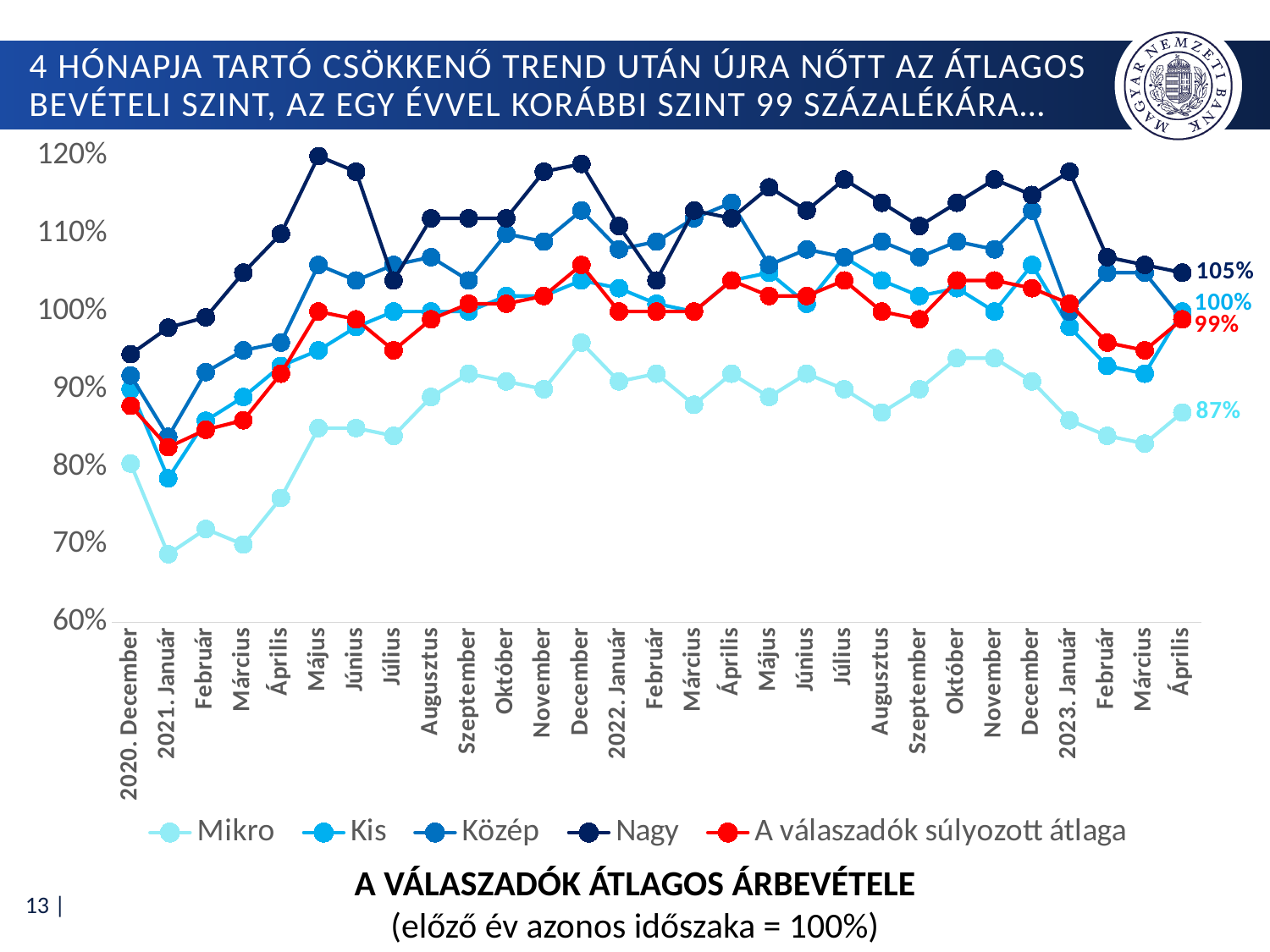
Is the value for Nagy in 2021 December greater or less than 110%? greater Which series has the lowest value in 2023 Április? Mikro Which series has the highest value in 2023 Április? Nagy What kind of chart is shown on the slide? Line chart What is the title of the chart? A VÁLASZADÓK ÁTLAGOS ÁRBEVÉTELE (előző év azonos időszaka = 100%) Is the value for Mikro in 2021 Január greater or less than 70%? less How many series does the legend list? 5 What value is labelled at the end of the Mikro line (2023 Április)? 87% What is the difference between the labelled Nagy value (105%) and the labelled Mikro value (87%) in 2023 Április? 18 percentage points What value is labelled at the end of the Nagy line (2023 Április)? 105% How many months (points) are shown along the x axis? 29 What value is labelled at the end of the 'A válaszadók súlyozott átlaga' line (2023 Április)? 99%